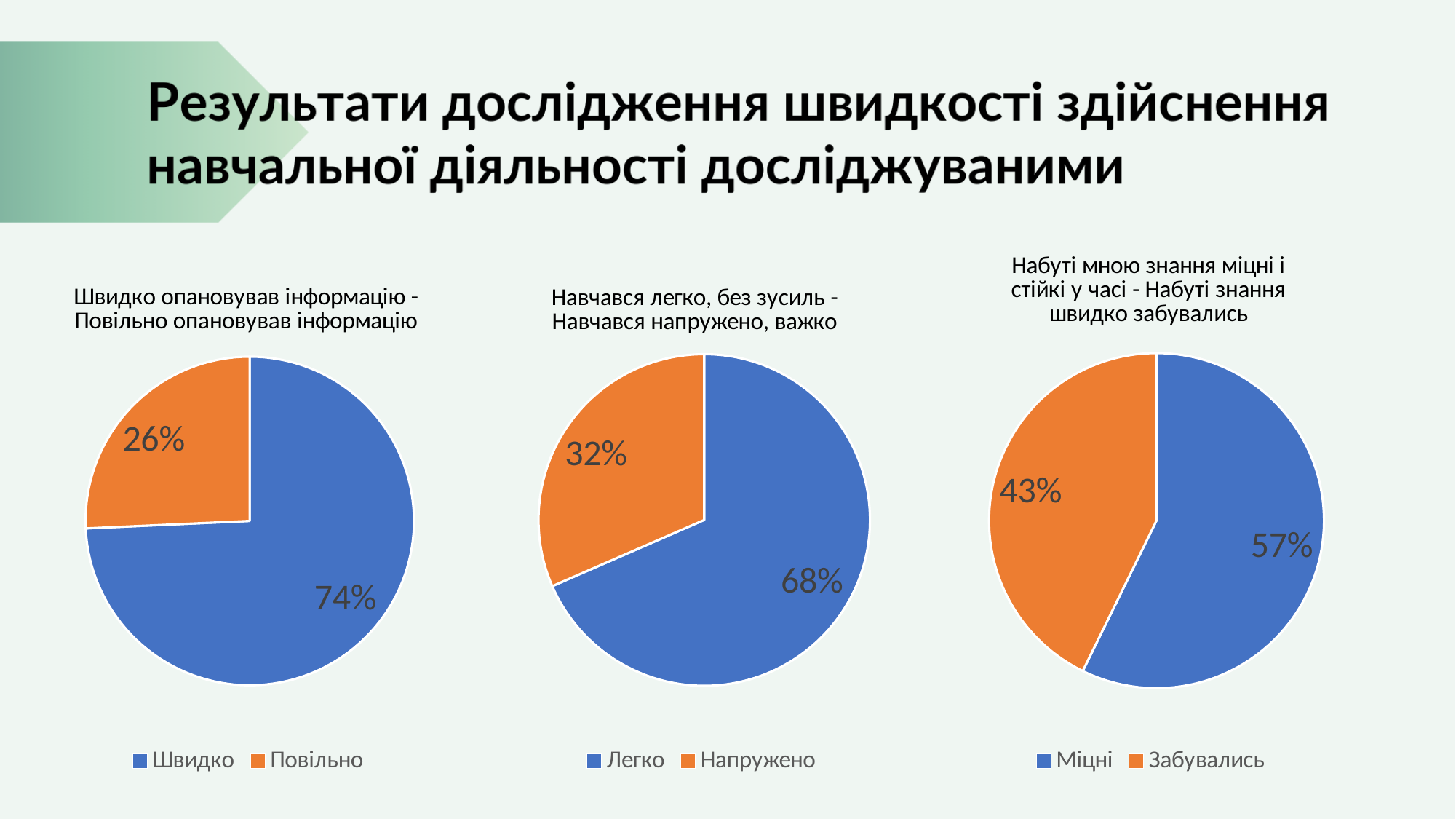
In the right pie chart, which slice is larger, Міцні or Забувались? Міцні In the middle pie chart, what is the difference between the Легко and Напружено shares? 36% In the middle pie chart, what share is labelled for Легко? 68% In the left pie chart, which colour represents Повільно? Orange What type of chart is used for the three charts on the slide? Pie chart In the left pie chart, what is the difference between the Швидко and Повільно shares? 48% In the right pie chart, what share is labelled for Забувались? 43% In the left pie chart, what share is labelled for Повільно? 26% In the middle pie chart, what share is labelled for Напружено? 32% How many slices does the middle pie chart have? 2 In the right pie chart, what share is labelled for Міцні? 57% In the left pie chart, what share is labelled for Швидко? 74%